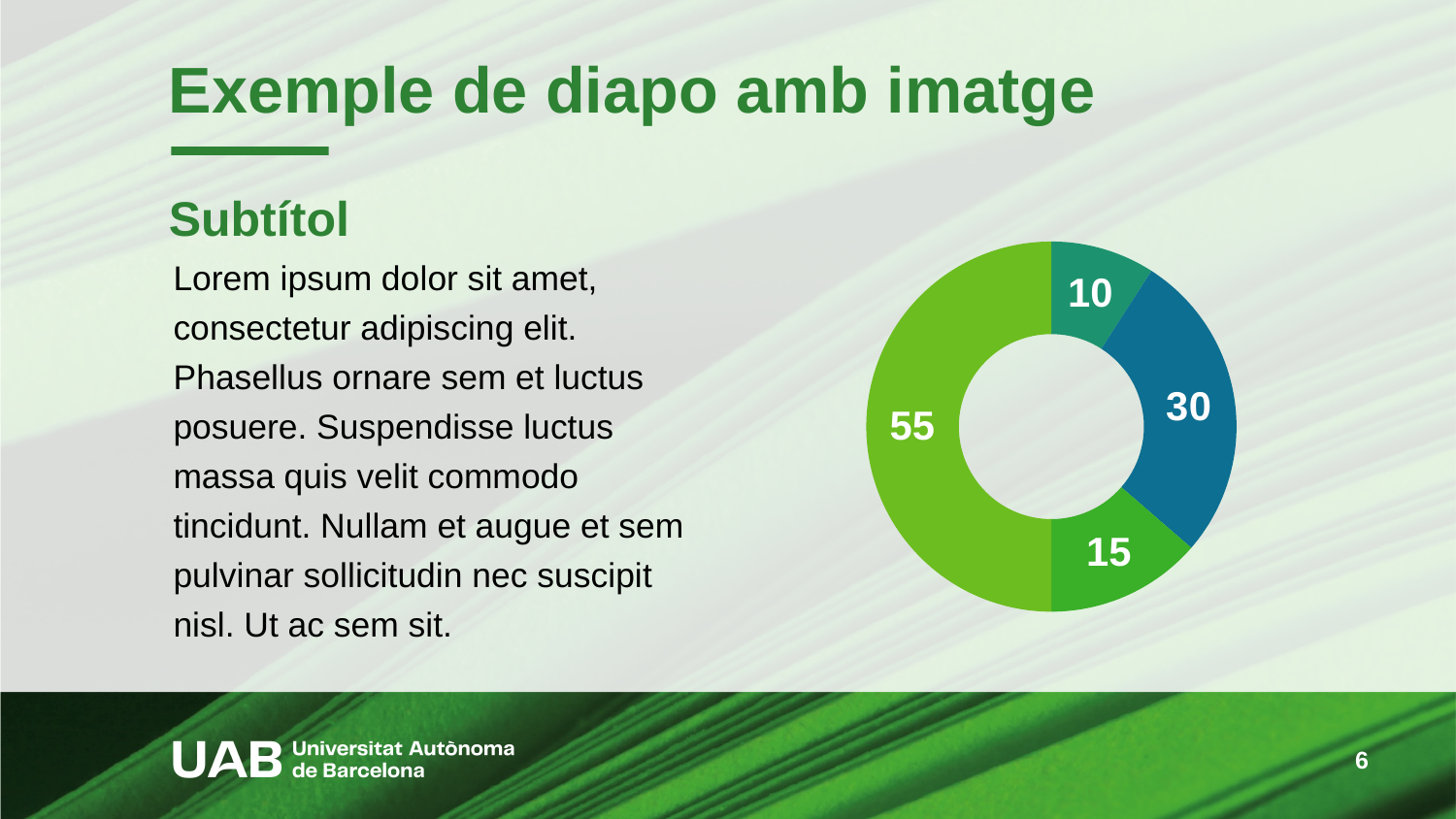
What value is shown on the dark blue slice of the doughnut chart? 30 What is the total of all the values shown on the doughnut chart? 110 What is the difference between the slice labelled 15 and the slice labelled 10? 5 How many slices does the doughnut chart have? 4 Which is larger, the slice labelled 30 or the slice labelled 15? 30 What kind of chart is shown on the slide? doughnut chart What is the smallest value shown on the doughnut chart? 10 Does the doughnut chart have a legend? No What share of the doughnut chart does the slice labelled 55 represent? 50% What value is shown on the teal slice at the top of the doughnut chart? 10 What is the largest value shown on the doughnut chart? 55 What is the difference between the largest slice (55) and the dark blue slice (30)? 25